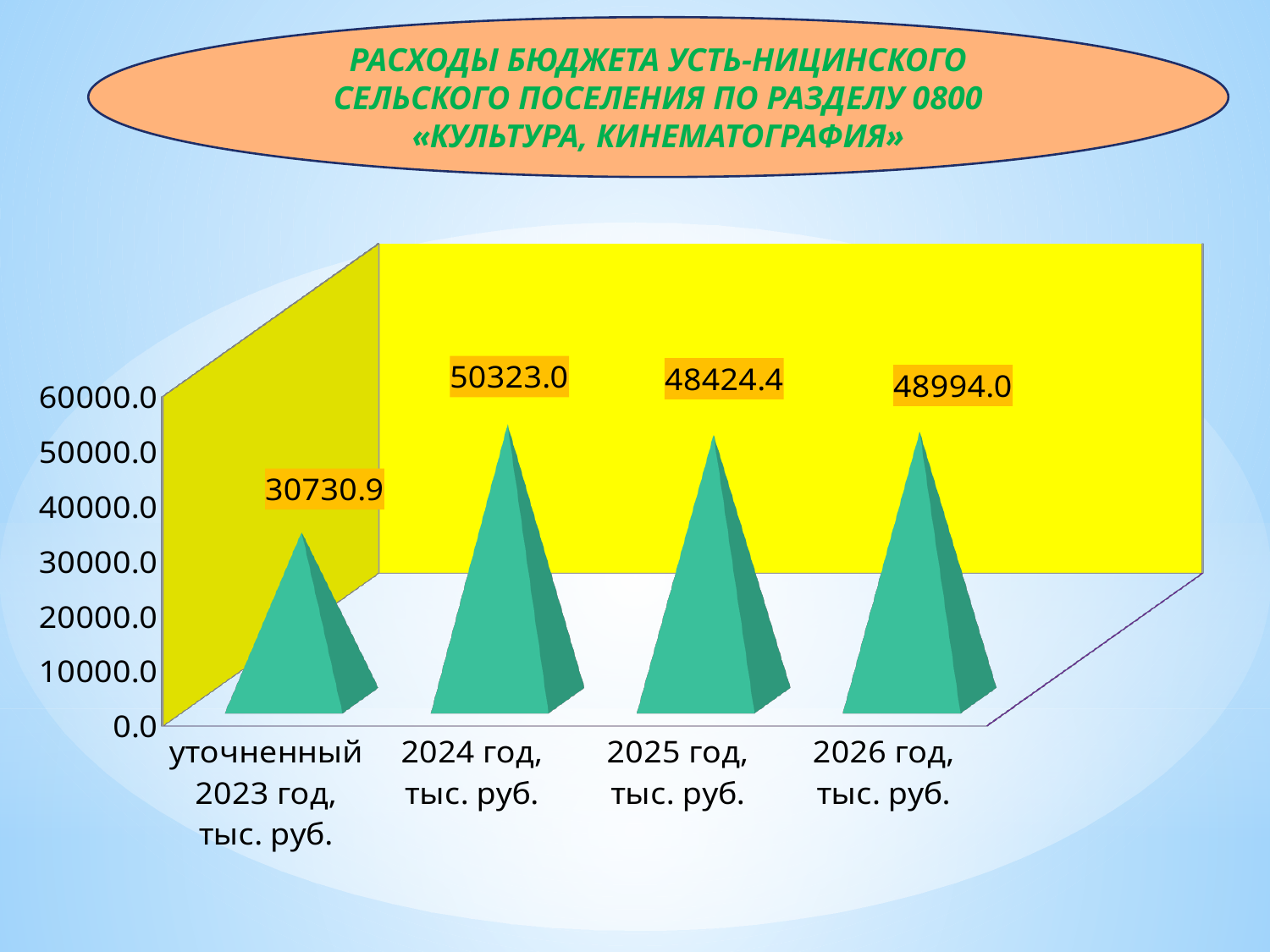
What is the value for 2024 год, тыс. руб.? 50323.0 Which is larger, the value for 2025 год or the value for 2026 год? 2026 год, тыс. руб. What is the value for 2026 год, тыс. руб.? 48994.0 How many categories are shown on the x axis? 4 Which category has the highest value? 2024 год, тыс. руб. What is the difference between the values for 2026 год and 2025 год? 569.6 Does the value rise or fall from уточненный 2023 год to 2024 год? rise What is the value for уточненный 2023 год, тыс. руб.? 30730.9 Which category has the lowest value? уточненный 2023 год, тыс. руб. What kind of chart is shown on the slide? bar chart What is the value for 2025 год, тыс. руб.? 48424.4 What is the difference between the values for 2024 год and уточненный 2023 год? 19592.1